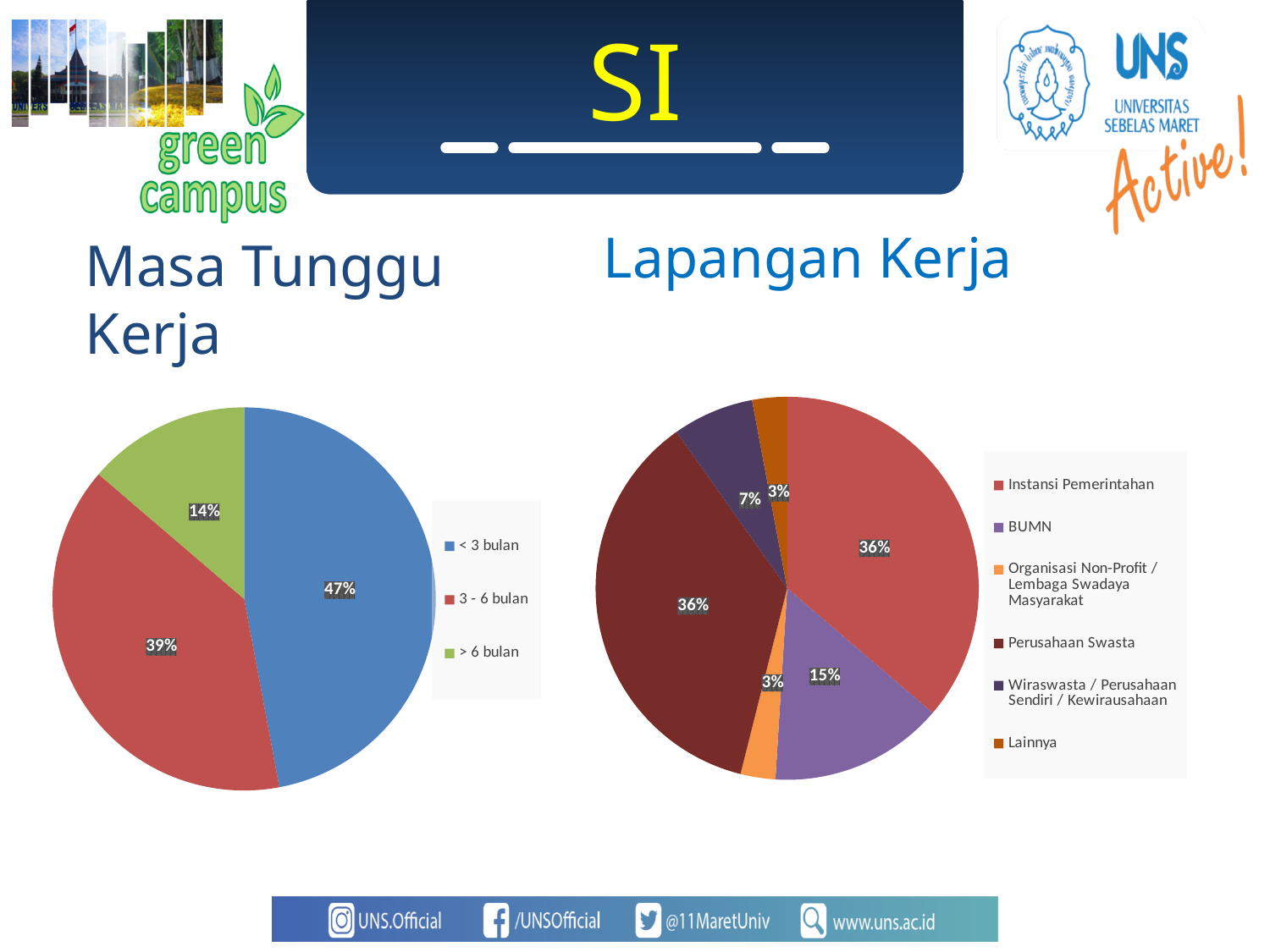
What type of chart is used for Lapangan Kerja? Pie chart How many categories does the legend of the Lapangan Kerja pie chart list? 6 In the Lapangan Kerja pie chart, what share is labelled for Perusahaan Swasta? 36% In the Masa Tunggu Kerja pie chart, what share is labelled for < 3 bulan? 47% In the Lapangan Kerja pie chart, what share is labelled for Wiraswasta / Perusahaan Sendiri / Kewirausahaan? 7% In the Masa Tunggu Kerja pie chart, which category has the smallest share? > 6 bulan In the Masa Tunggu Kerja pie chart, what share is labelled for 3 - 6 bulan? 39% In the Lapangan Kerja pie chart, which is larger, the share for BUMN or the share for Lainnya? BUMN In the Masa Tunggu Kerja pie chart, which category has the largest share? < 3 bulan How many categories does the Masa Tunggu Kerja pie chart show? 3 In the Lapangan Kerja pie chart, what share is labelled for BUMN? 15% In the Masa Tunggu Kerja pie chart, what is the difference between the shares for < 3 bulan and > 6 bulan? 33%